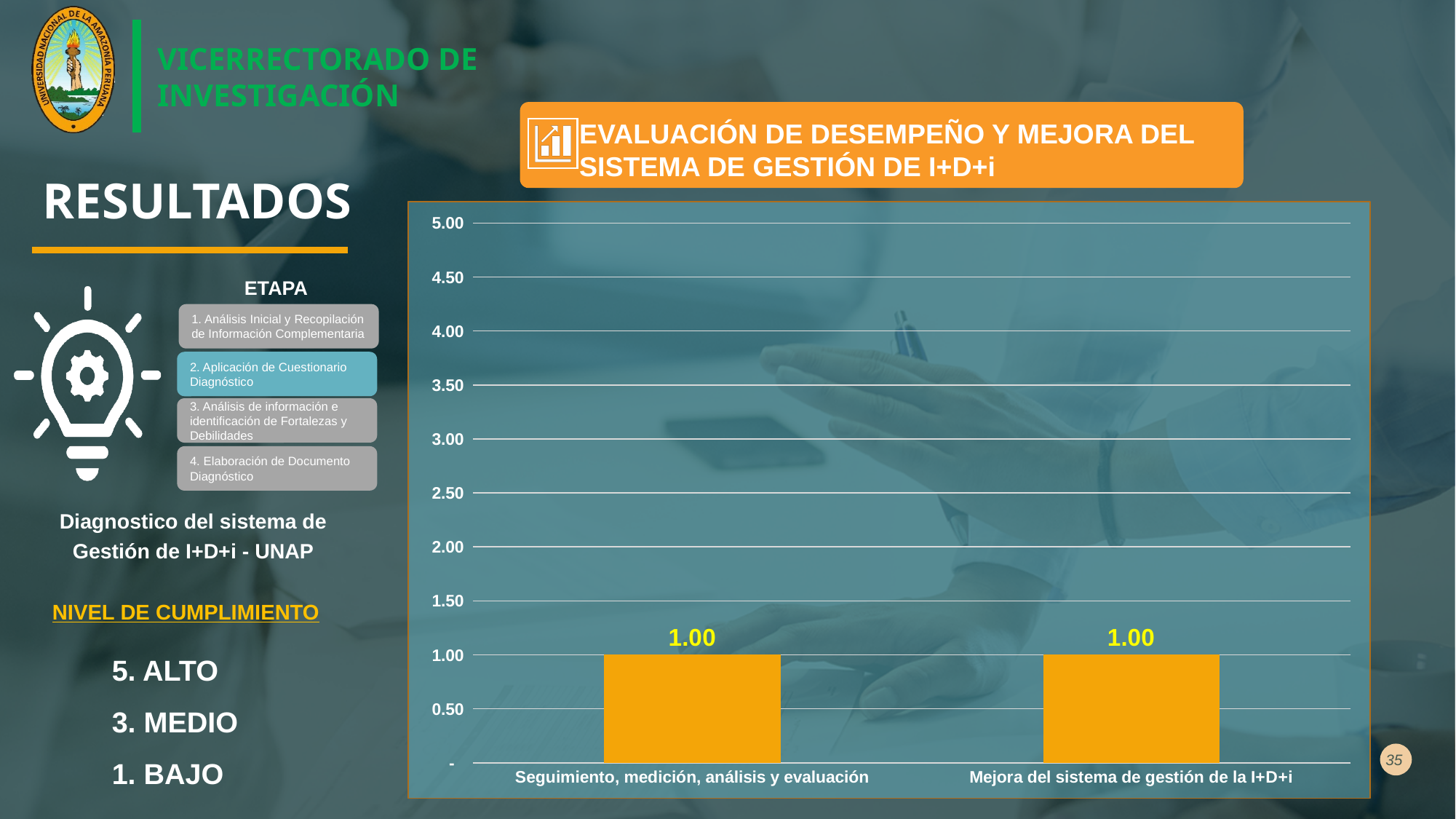
What is the value for 'Seguimiento, medición, análisis y evaluación'? 1.00 What is the highest value shown on the chart's vertical axis? 5.00 Is the value for 'Mejora del sistema de gestión de la I+D+i' greater or less than 3.00? less What kind of chart is shown on the slide? Bar chart What is the difference between the values for 'Seguimiento, medición, análisis y evaluación' and 'Mejora del sistema de gestión de la I+D+i'? 0.00 What is the title of the chart? EVALUACIÓN DE DESEMPEÑO Y MEJORA DEL SISTEMA DE GESTIÓN DE I+D+i Is the value for 'Seguimiento, medición, análisis y evaluación' greater or less than 2.00? less What is the value for 'Mejora del sistema de gestión de la I+D+i'? 1.00 How many categories are plotted on the chart? 2